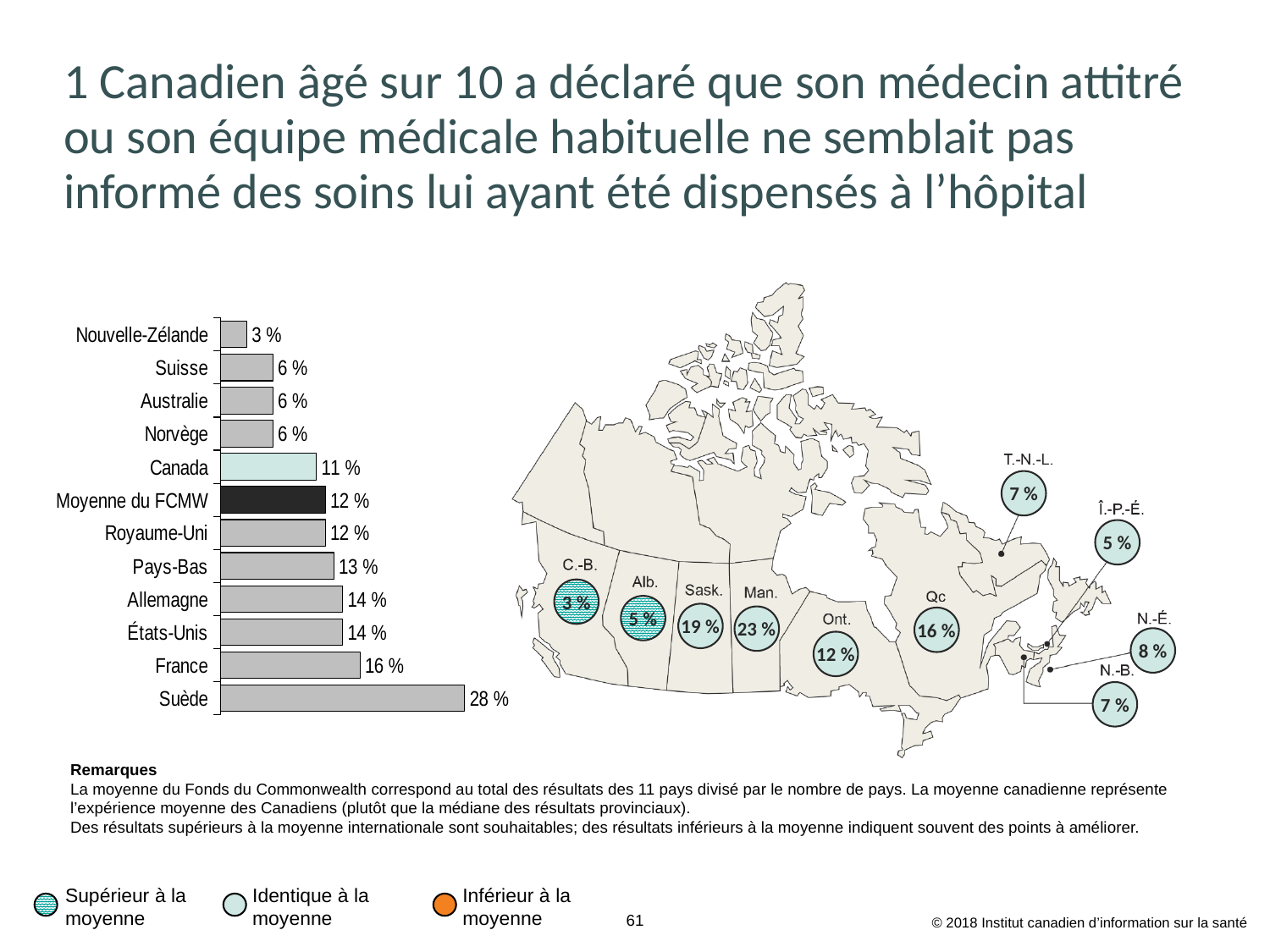
On the map of Canada, what is the value shown for Man.? 23 % In the bar chart, which is larger, the value for France or the value for Allemagne? France In the bar chart, what is the value for Canada? 11 % In the bar chart, do the values increase or decrease going from the top bar to the bottom bar? increase How many bars are shown in the bar chart? 12 In the bar chart, what is the value for Moyenne du FCMW? 12 % On the map of Canada, what is the difference between the values for Qc and Ont.? 4 % In the bar chart, which country has the lowest value? Nouvelle-Zélande In the bar chart, which country has the highest value? Suède On the map of Canada, which province has the lowest value? C.-B. In the bar chart, what is the difference between the values for Suède and Canada? 17 % What kind of chart is shown on the left of the slide? bar chart